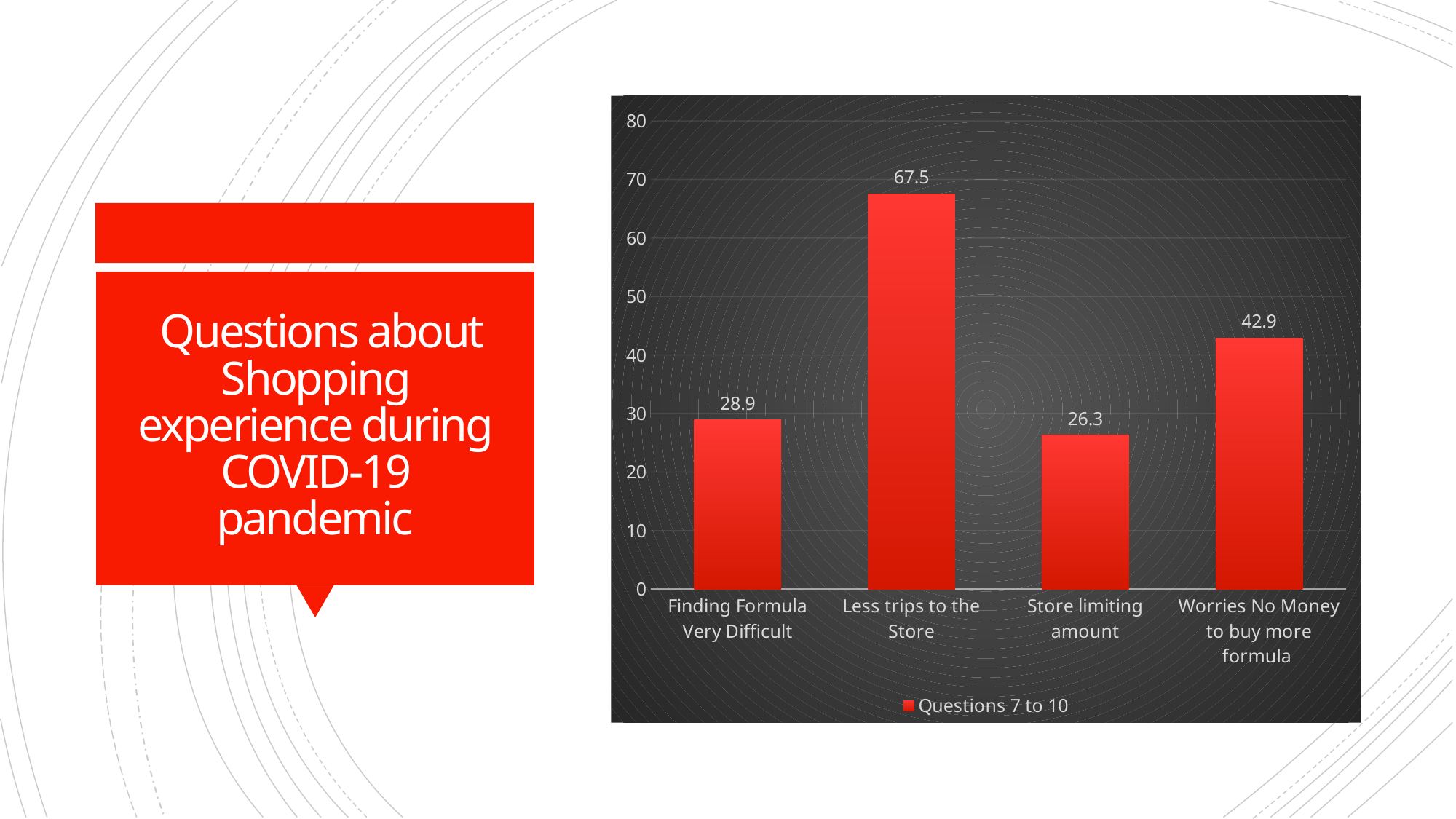
What is the value for "Worries No Money to buy more formula"? 42.9 What is the value for "Store limiting amount"? 26.3 What kind of chart is shown on the slide? Bar chart Which category has the highest value? Less trips to the Store What is the value for "Less trips to the Store"? 67.5 What is the difference between the values for "Less trips to the Store" and "Worries No Money to buy more formula"? 24.6 What is the value for "Finding Formula Very Difficult"? 28.9 How many categories are shown on the x axis? 4 Which is larger: the value for "Finding Formula Very Difficult" or "Store limiting amount"? Finding Formula Very Difficult Is the value for "Worries No Money to buy more formula" greater or less than 40? greater Which category has the lowest value? Store limiting amount What series name does the legend show? Questions 7 to 10